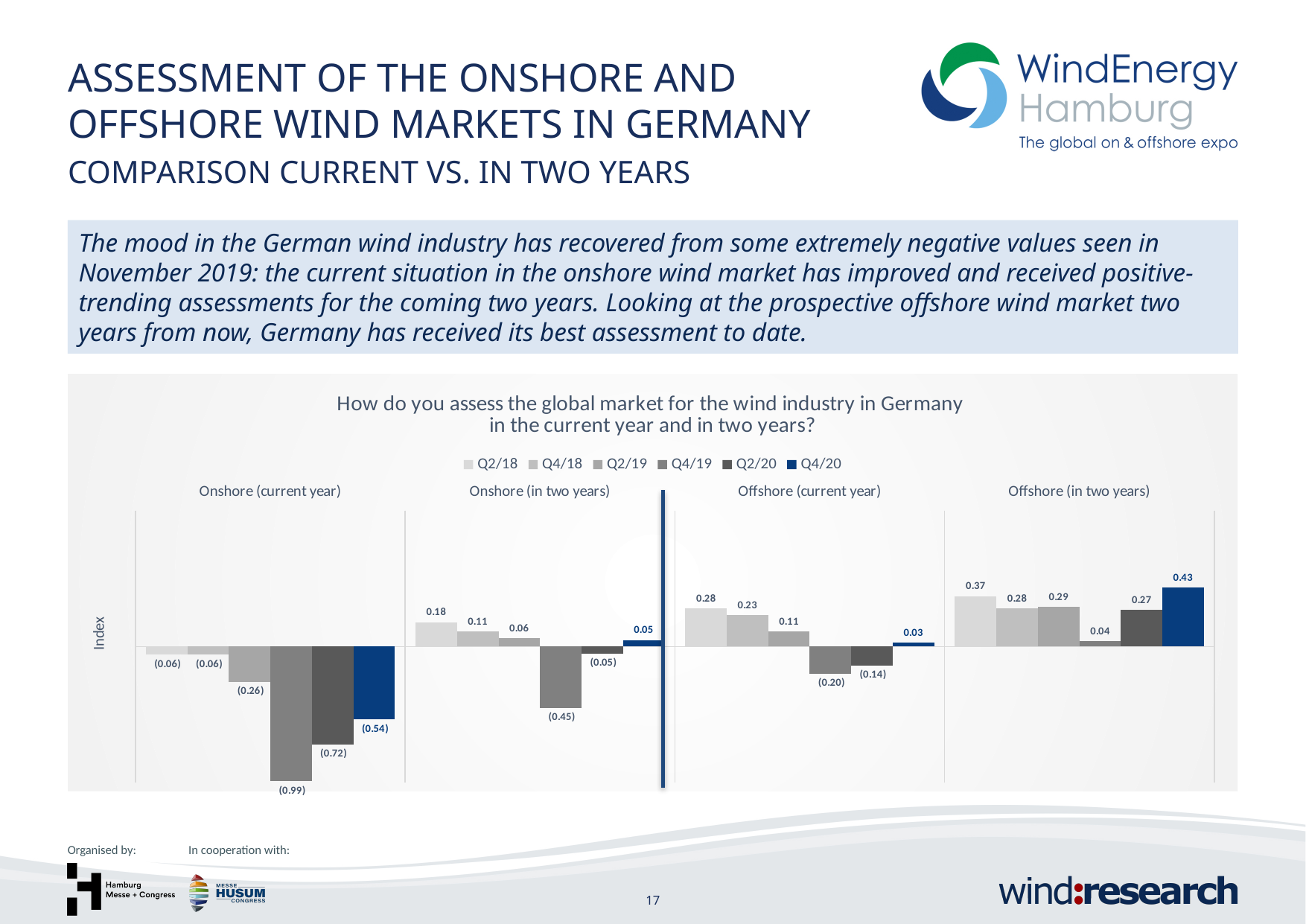
How many series does the legend list? 6 What is the value for Q4/19 in the Onshore (in two years) group? (0.45) In the Offshore (in two years) group, which is larger: the value for Q2/18 or the value for Q4/19? Q2/18 What is the value for Q2/19 in the Onshore (current year) group? (0.26) Which series has the highest value in the Onshore (in two years) group? Q2/18 Which series has the highest value in the Offshore (in two years) group? Q4/20 Which series has the lowest value in the Onshore (current year) group? Q4/19 What kind of chart is shown on the slide? Bar chart What is the value for Q4/20 in the Offshore (in two years) group? 0.43 What is the value for Q2/18 in the Offshore (current year) group? 0.28 What is the label of the y axis? Index How many category groups are shown on the x axis? 4